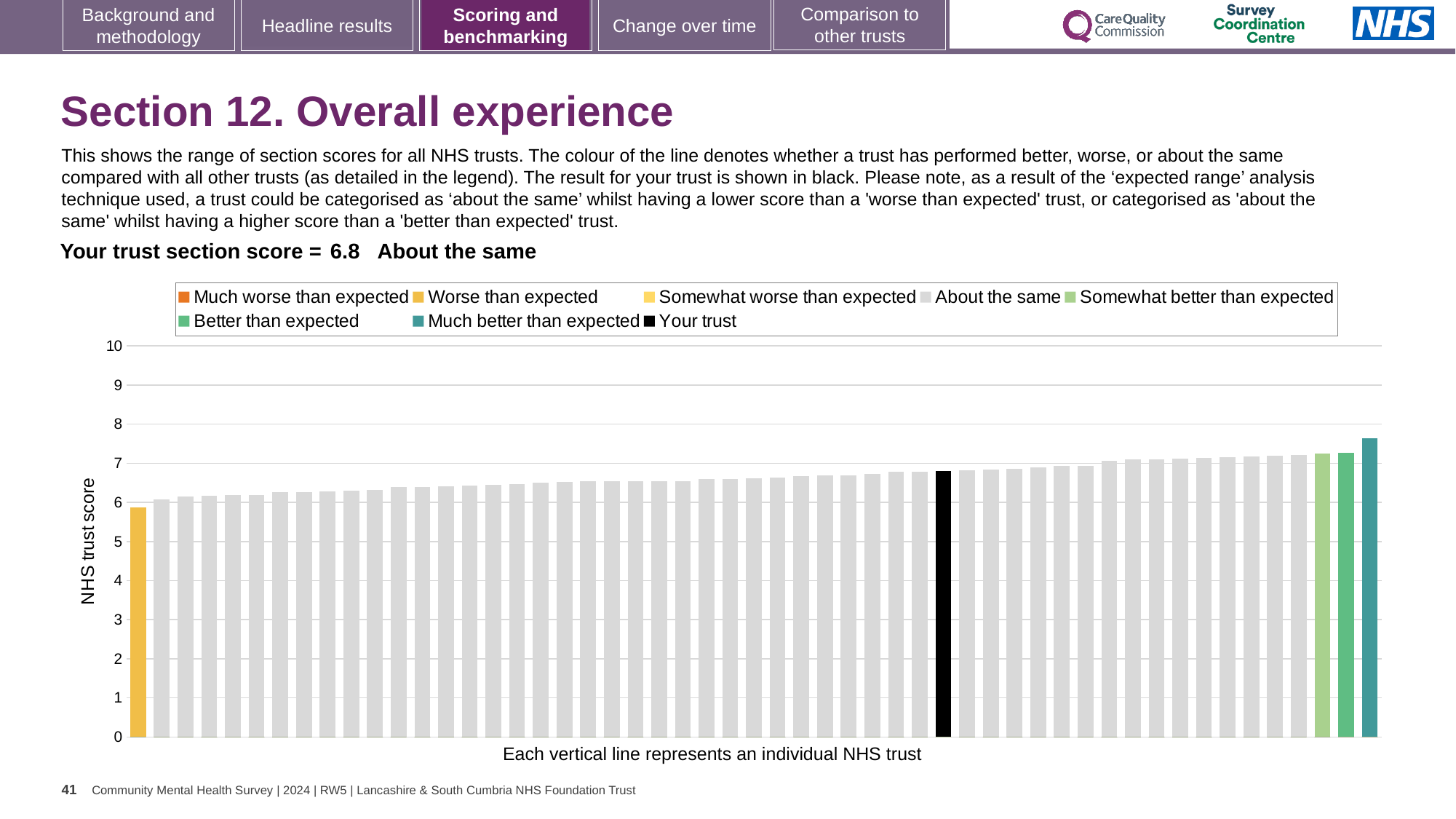
What is the section score for your trust shown on the slide? 6.8 Is the value of the rightmost bar greater or less than 7? greater What colour is the bar for your trust shown in? black Which legend category does the highest bar belong to? Much better than expected Is the bar for your trust higher or lower than the rightmost bar? lower How many entries does the chart legend list? 8 Do the bar values rise or fall from left to right along the x axis? rise Is the value of the leftmost bar greater or less than 5? greater What kind of chart is shown on the slide? bar chart Is the value of the bar for your trust greater or less than 6? greater What is the label on the vertical axis of the chart? NHS trust score Which legend category does the lowest bar belong to? Worse than expected